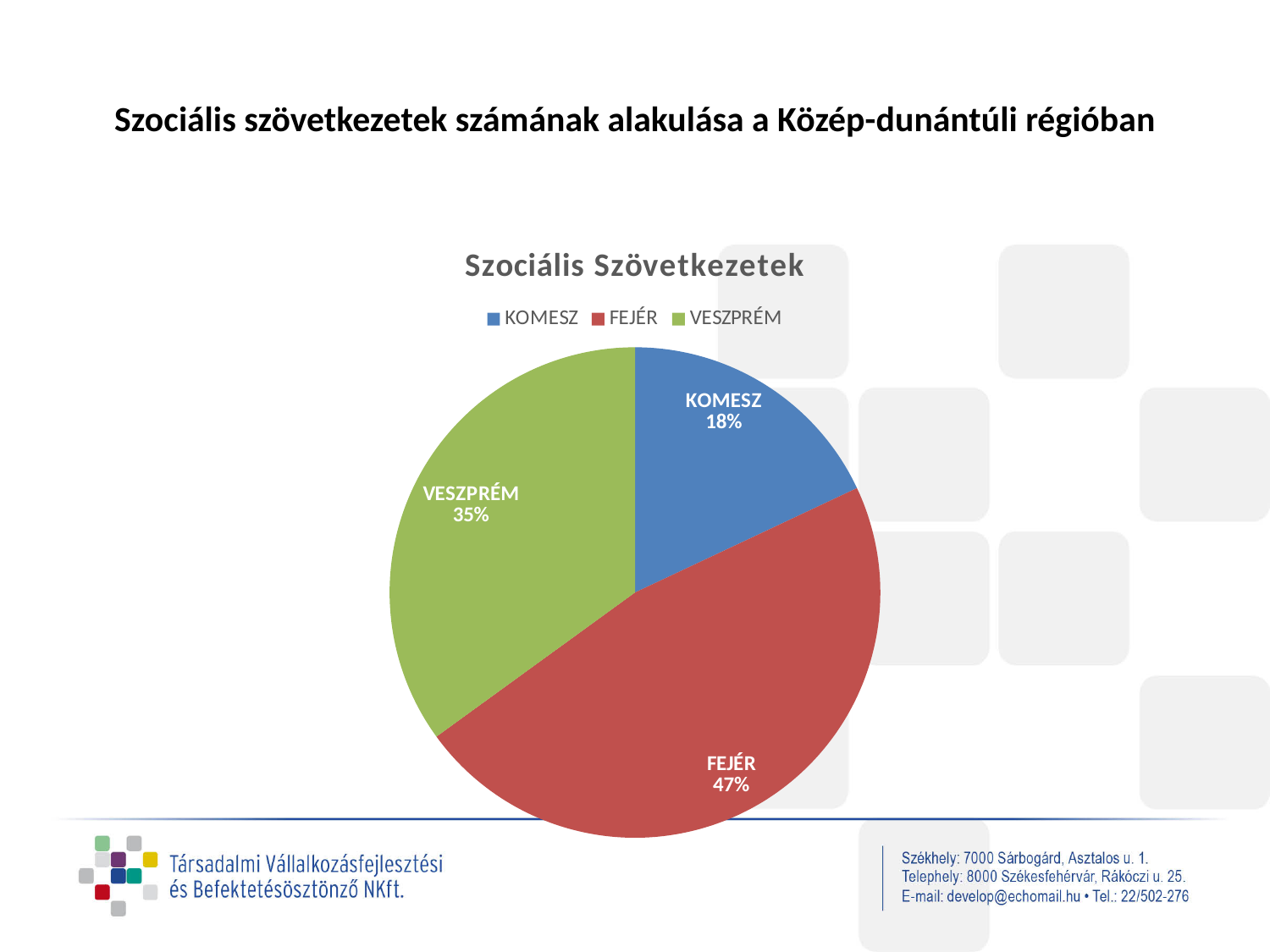
What is the difference in percentage points between the FEJÉR and VESZPRÉM slices? 12 What percentage share does FEJÉR have in the pie chart? 47% What percentage share does KOMESZ have in the pie chart? 18% How many entries does the legend list? 3 Which category has the smallest slice of the pie chart? KOMESZ What colour is the FEJÉR slice in the pie chart? Red What type of chart is shown on the slide? Pie chart Which slice is larger, VESZPRÉM or KOMESZ? VESZPRÉM Which category has the largest slice of the pie chart? FEJÉR How many slices does the pie chart have? 3 What percentage share does VESZPRÉM have in the pie chart? 35% What is the title of the chart? Szociális Szövetkezetek